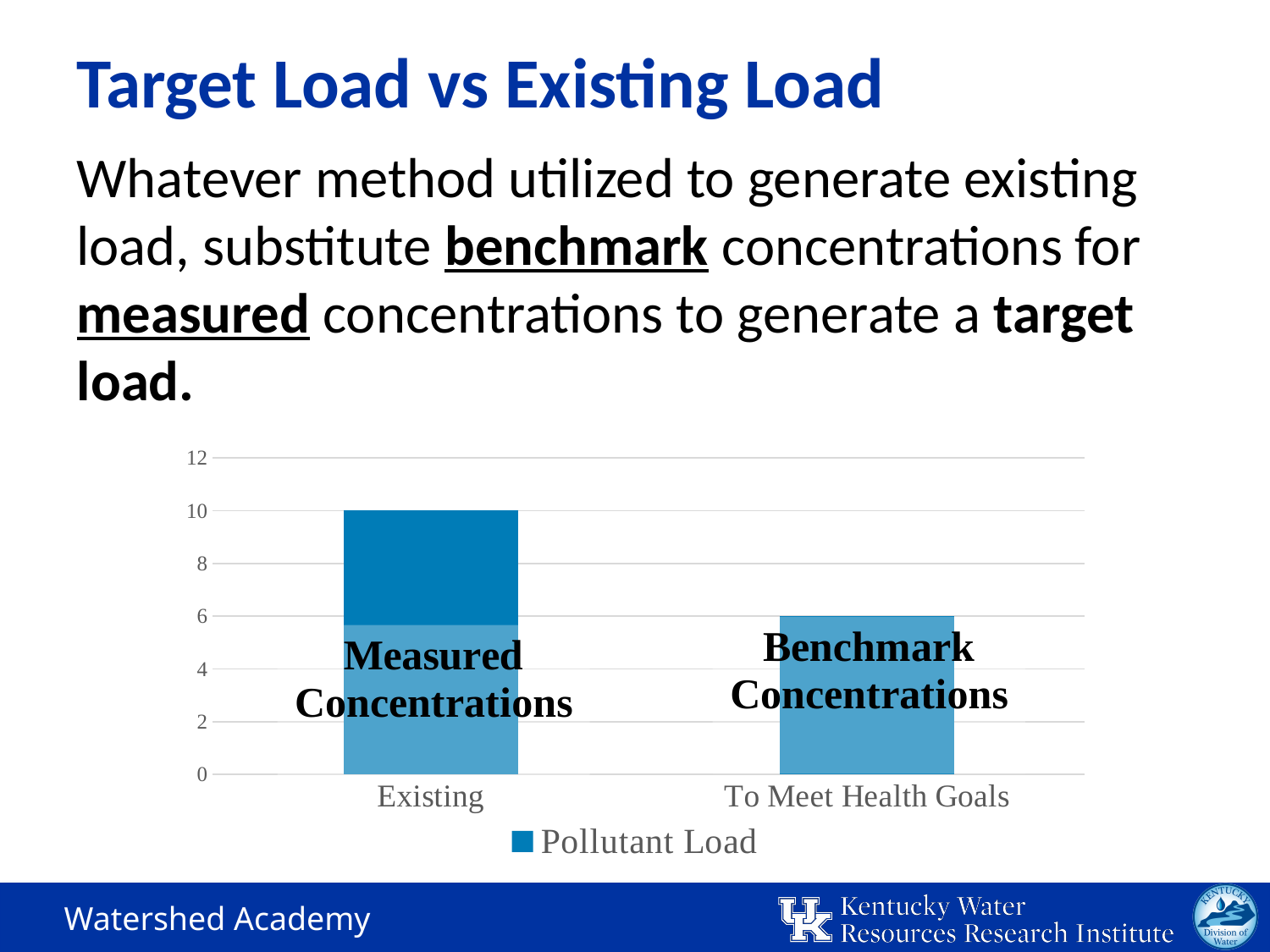
Is the Pollutant Load for To Meet Health Goals greater or less than 8? less What series name is shown in the chart legend? Pollutant Load What kind of chart is shown on the slide? Bar chart Which category has the lowest Pollutant Load? To Meet Health Goals Which category has the highest Pollutant Load? Existing What is the Pollutant Load value for the Existing category? 10 Is the Pollutant Load for Existing greater or less than 8? greater What is the difference in Pollutant Load between Existing and To Meet Health Goals? 4 How many series does the chart legend list? 1 How many categories are shown on the x axis of the chart? 2 What is the Pollutant Load value for the To Meet Health Goals category? 6 Which is larger, the Pollutant Load for Existing or for To Meet Health Goals? Existing